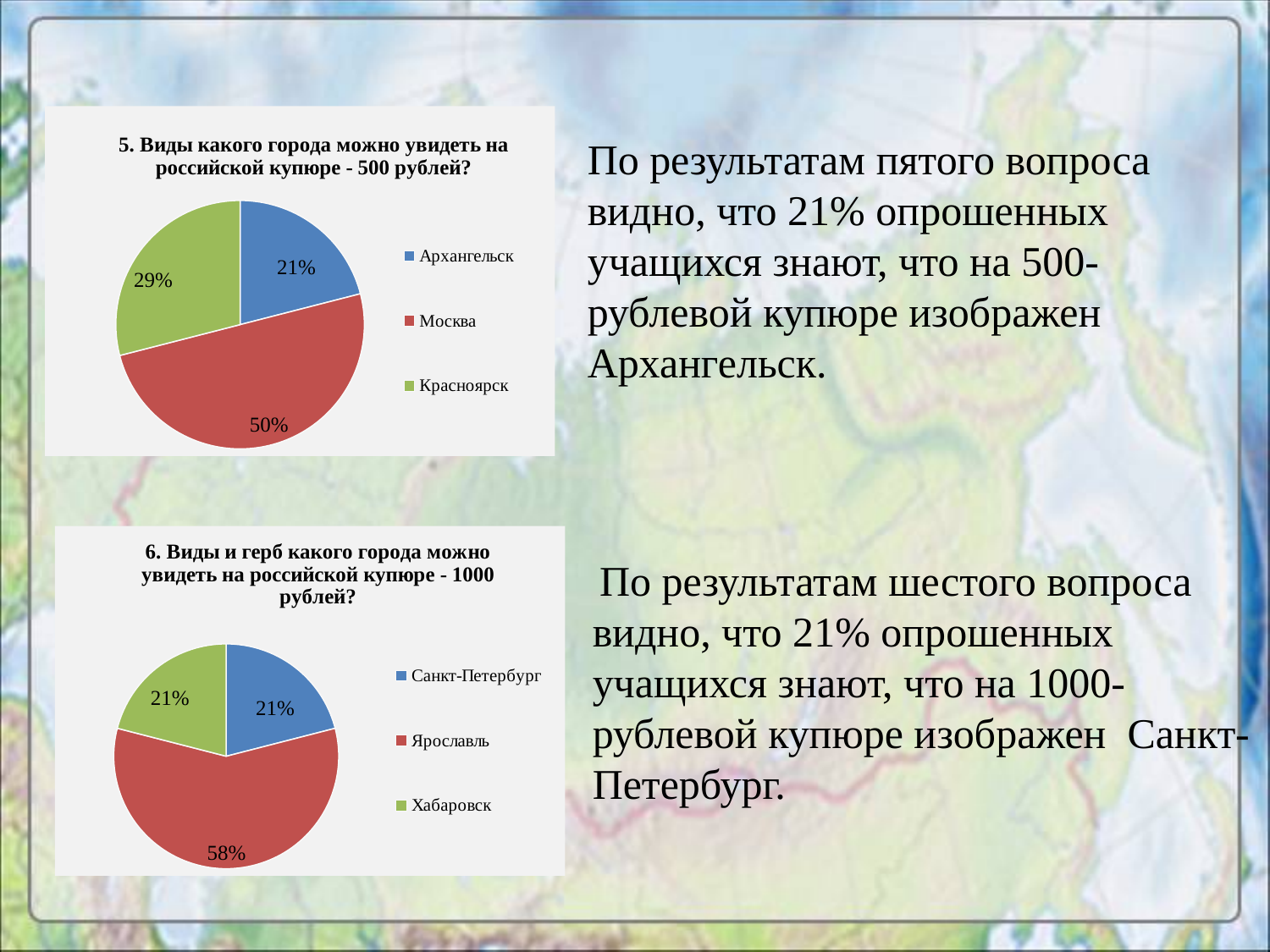
In the bottom pie chart (question 6, about the 1000-ruble note), what share is shown for Санкт-Петербург? 21% In the top pie chart (question 5, about the 500-ruble note), what is the difference in percentage points between Москва and Красноярск? 21 In the top pie chart (question 5, about the 500-ruble note), what share is shown for Москва? 50% In the bottom pie chart (question 6, about the 1000-ruble note), which city has the largest slice? Ярославль In the bottom pie chart (question 6, about the 1000-ruble note), which colour represents Хабаровск? Green In the bottom pie chart (question 6, about the 1000-ruble note), how many categories does the legend list? 3 In the bottom pie chart (question 6, about the 1000-ruble note), what share is shown for Ярославль? 58% In the top pie chart (question 5, about the 500-ruble note), what share is shown for Красноярск? 29% What type of chart is used for question 5 at the top of the slide? Pie chart In the top pie chart (question 5, about the 500-ruble note), which city has the smallest slice? Архангельск In the top pie chart (question 5, about the 500-ruble note), which city has the largest slice? Москва In the top pie chart (question 5, about the 500-ruble note), what share is shown for Архангельск? 21%